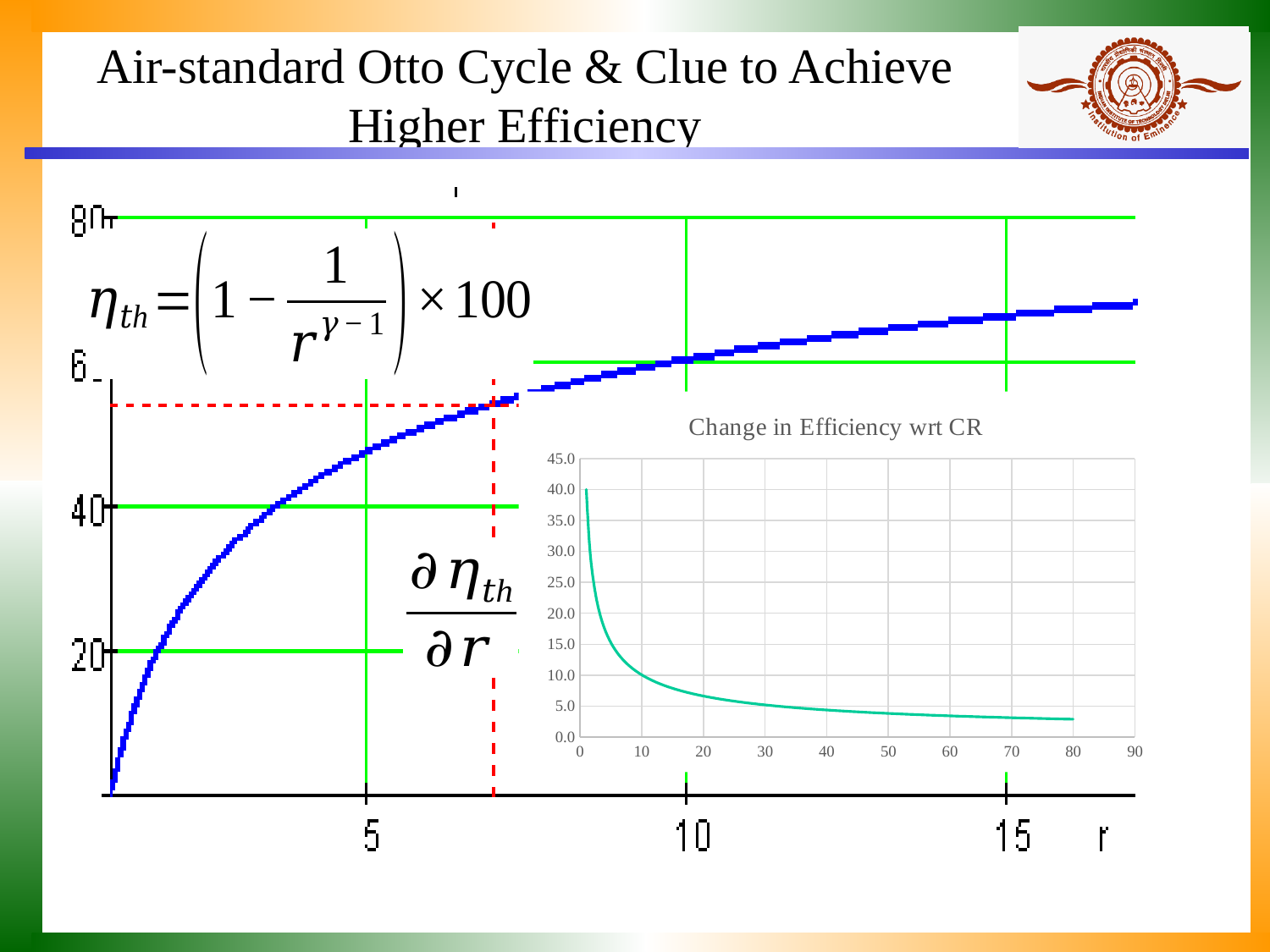
In the large chart of efficiency versus r, is the value at r = 15 greater or less than 60? greater In the large chart of efficiency versus r, is the value at r = 2 greater or less than 40? less In the inset chart 'Change in Efficiency wrt CR', is the value at x = 40 greater or less than 10.0? less In the large chart of efficiency versus r, which is larger: the value at r = 5 or the value at r = 15? r = 15 In the large chart of efficiency versus r, do the values rise or fall as r increases? rise In the inset chart 'Change in Efficiency wrt CR', do the values rise or fall as the x axis increases? fall In the inset chart 'Change in Efficiency wrt CR', what kind of chart is shown? line chart What is the title of the inset chart on the right side of the slide? Change in Efficiency wrt CR In the inset chart 'Change in Efficiency wrt CR', what is the highest value shown on the y axis? 45.0